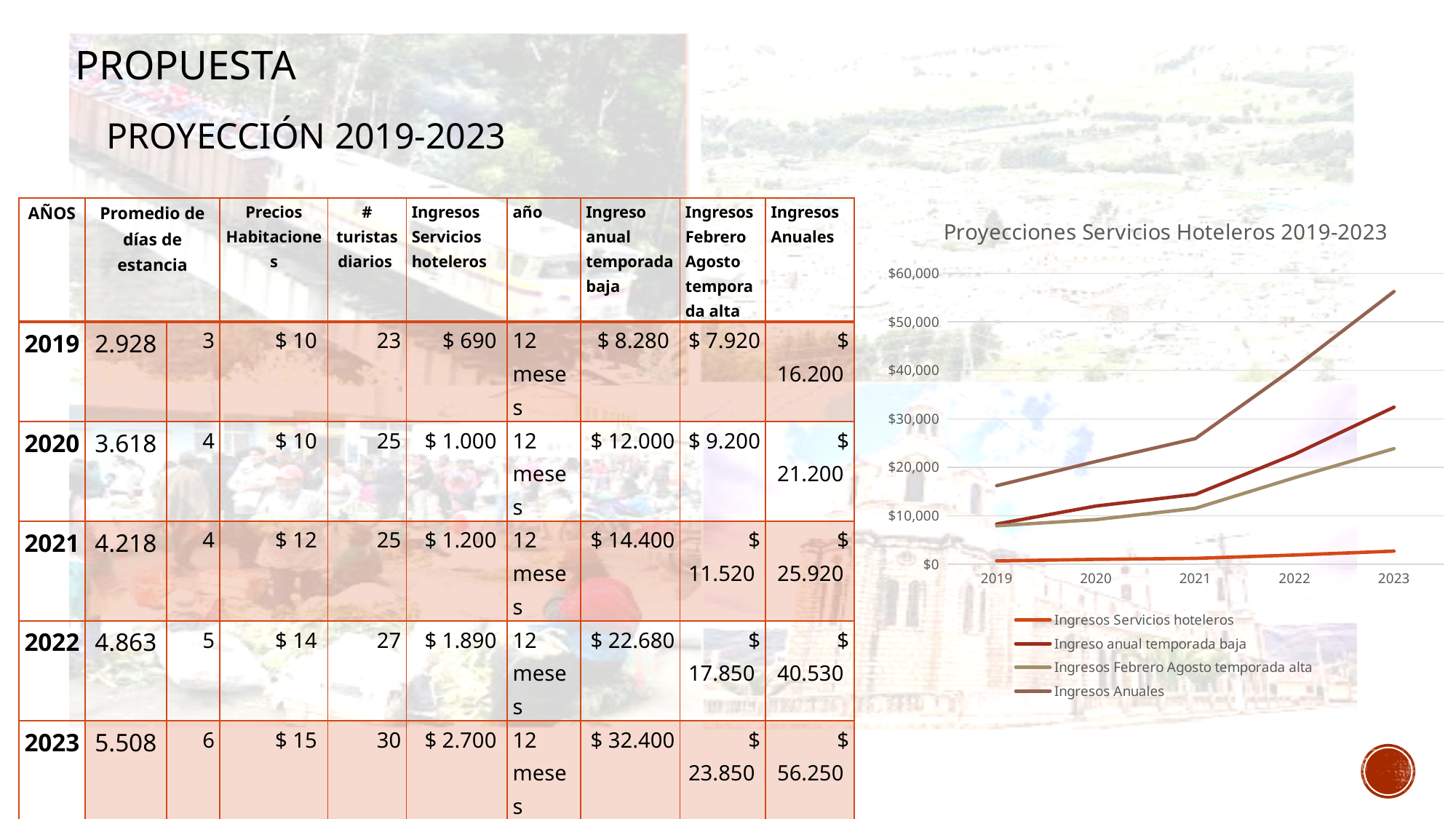
Is the value for Ingresos Anuales in 2019 greater or less than $20,000? less Which series has the lowest values across all years in the chart? Ingresos Servicios hoteleros Does the Ingresos Anuales line rise or fall from 2019 to 2023? rise What is the title of the chart on the slide? Proyecciones Servicios Hoteleros 2019-2023 What kind of chart is shown on the slide? line chart Which series has the highest value in 2023? Ingresos Anuales Is the value for Ingresos Anuales in 2023 greater or less than $50,000? greater How many series does the chart's legend list? 4 How many years are shown along the x axis of the chart? 5 Is the value for Ingresos Servicios hoteleros in 2023 greater or less than $10,000? less In 2022, which is larger: Ingreso anual temporada baja or Ingresos Febrero Agosto temporada alta? Ingreso anual temporada baja